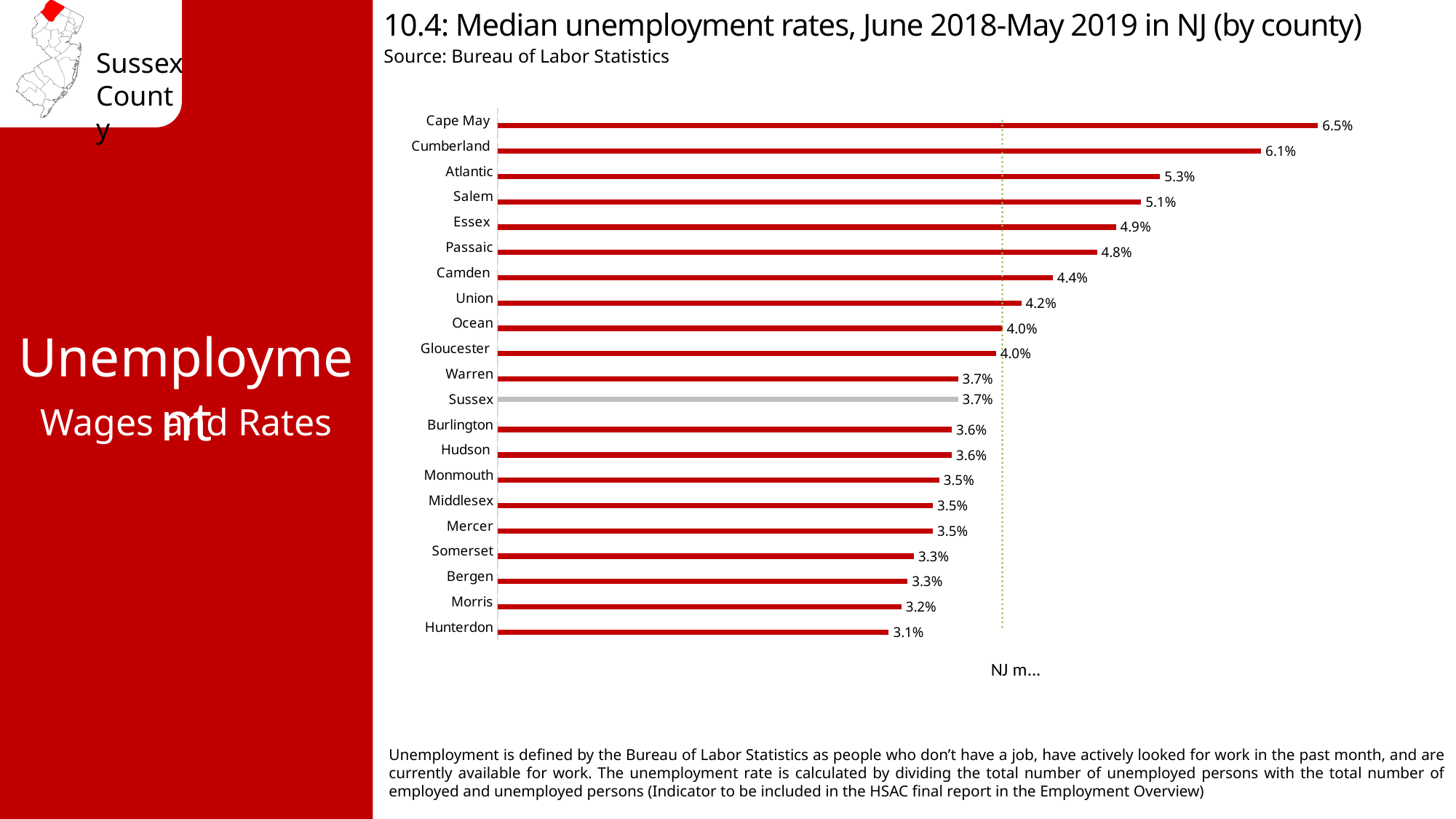
Which has a higher median unemployment rate, Morris or Somerset? Somerset Which county's bar is shown in grey instead of red? Sussex Which county has the lowest median unemployment rate? Hunterdon What is the difference between the median unemployment rates of Cape May and Hunterdon? 3.4% What is the median unemployment rate for Cape May? 6.5% What is the median unemployment rate for Camden? 4.4% Which county has the highest median unemployment rate? Cape May What is the median unemployment rate for Sussex County? 3.7% Which has a higher median unemployment rate, Essex or Passaic? Essex How many counties are shown in the chart? 21 What is the difference between the median unemployment rates of Cumberland and Sussex? 2.4% What kind of chart is used to show the median unemployment rates? Bar chart